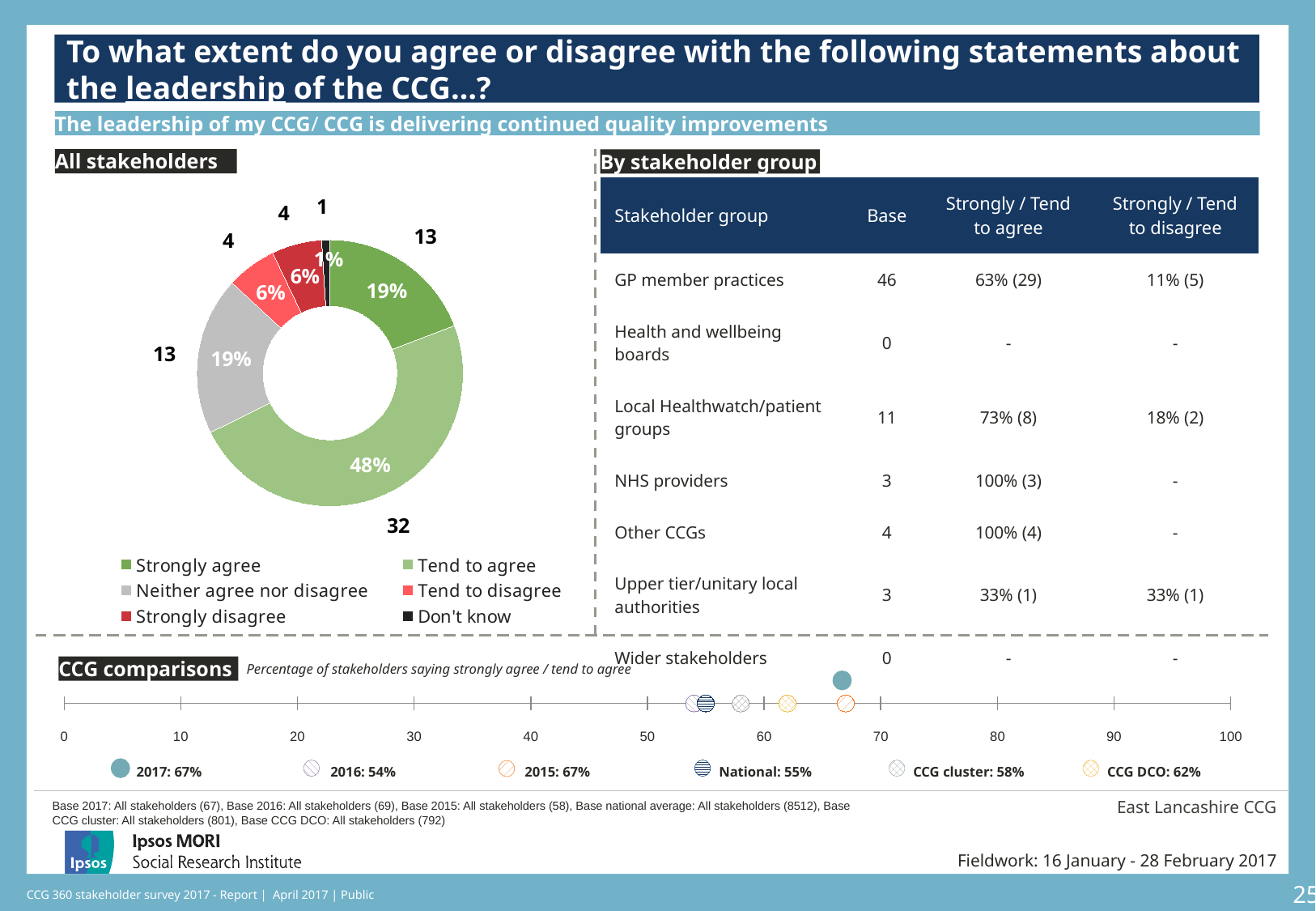
In the 'All stakeholders' donut chart, what percentage of stakeholders said 'Tend to agree'? 48% In the 'All stakeholders' donut chart, which colour represents 'Neither agree nor disagree'? Grey In the 'CCG comparisons' chart, is the 2017 value larger or smaller than the National value? Larger In the 'All stakeholders' donut chart, which response category has the largest share? Tend to agree In the 'All stakeholders' donut chart, what is the difference in percentage points between 'Tend to agree' and 'Neither agree nor disagree'? 29 What type of chart is used for the 'All stakeholders' section? Donut chart In the 'All stakeholders' donut chart, how many stakeholders answered 'Don't know'? 1 In the 'All stakeholders' donut chart, how many response categories does the legend list? 6 In the 'All stakeholders' donut chart, which response category has the smallest share? Don't know In the 'CCG comparisons' chart, which comparator has the lowest percentage? 2016: 54% In the 'CCG comparisons' chart, what percentage of stakeholders said strongly agree / tend to agree in 2017? 67% In the 'All stakeholders' donut chart, what percentage of stakeholders said 'Strongly agree'? 19%